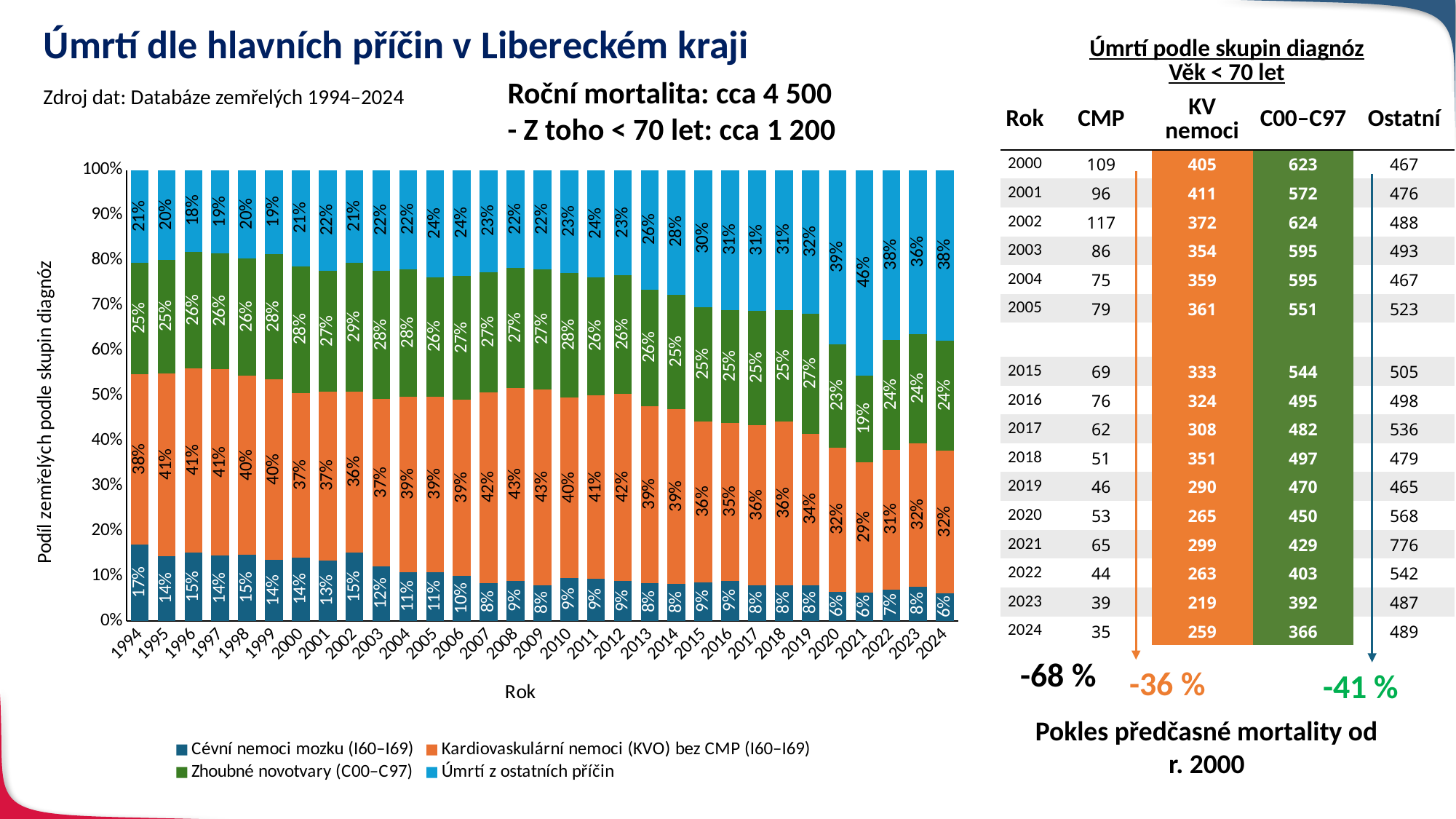
What is the share of Kardiovaskulární nemoci (KVO) bez CMP in 2008? 43% What is the share of Zhoubné novotvary (C00–C97) in 2024? 24% In which year is the share of Úmrtí z ostatních příčin the highest? 2021 What is the share of Úmrtí z ostatních příčin in 2021? 46% By how many percentage points does the share of Úmrtí z ostatních příčin in 2024 exceed that in 1994? 17 percentage points What is the share of Cévní nemoci mozku (I60–I69) in 1994? 17% Does the share of Cévní nemoci mozku (I60–I69) generally rise or fall from 1994 to 2024? Fall How many series does the chart legend list? 4 In which year is the share of Cévní nemoci mozku (I60–I69) the highest? 1994 What type of chart is shown on the slide? Stacked bar chart In 2021, which is larger: the share of Zhoubné novotvary (C00–C97) or the share of Kardiovaskulární nemoci (KVO) bez CMP? Kardiovaskulární nemoci (KVO) bez CMP How many years are shown on the x axis of the chart? 31